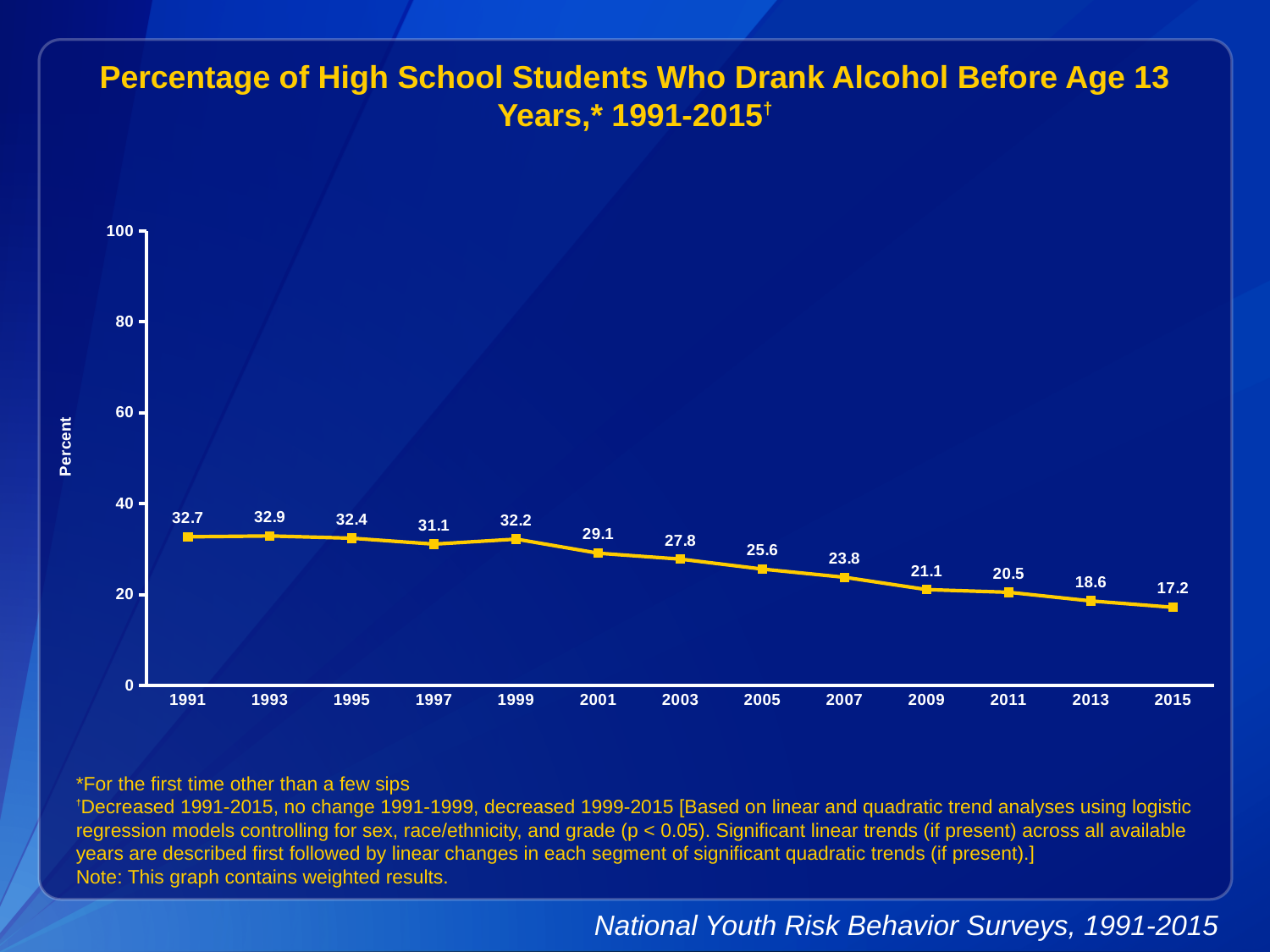
Which year has the lowest value on the chart? 2015 What kind of chart is shown on the slide? line chart How many years are plotted on the x axis? 13 What is the value plotted for 2003? 27.8 What is the difference between the 1991 value and the 2015 value? 15.5 What is the value plotted for 2015? 17.2 Is the value for 2009 greater or less than 40? less Do the values generally rise or fall from 1991 to 2015? fall Which is larger, the value for 1999 or the value for 2001? 1999 Which year has the highest value on the chart? 1993 What percentage of high school students drank alcohol before age 13 in 1991? 32.7 What is the label on the y axis? Percent